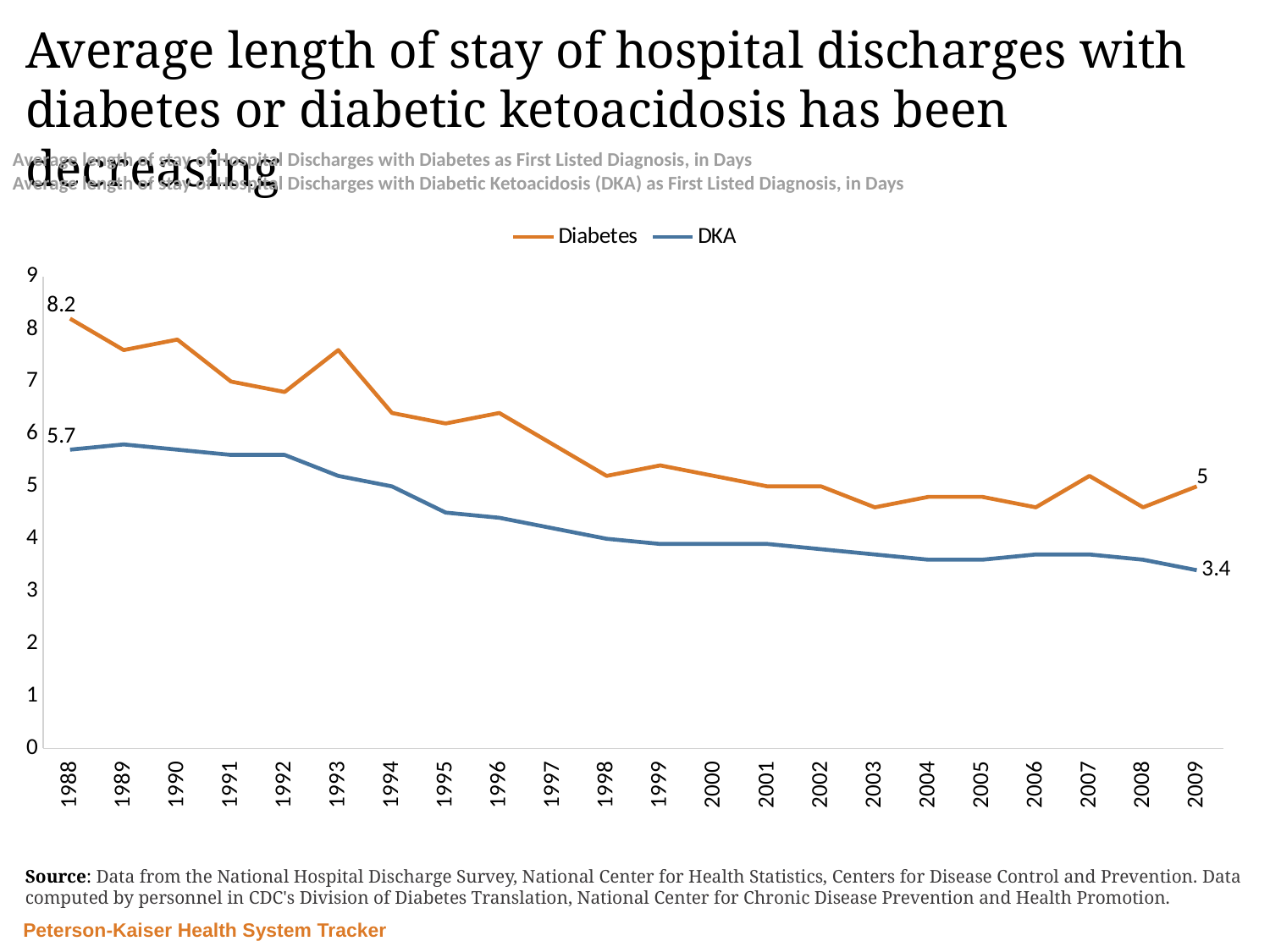
How many series does the legend list? 2 What is the difference between the Diabetes and DKA values in 1988? 2.5 What is the value for DKA in 1988? 5.7 Which series has the larger value in 2009, Diabetes or DKA? Diabetes What kind of chart is shown on the slide? line chart Is the value for DKA in 1995 greater or less than 5? less By how much did the Diabetes value fall from 1988 to 2009? 3.2 What is the value for Diabetes in 1988? 8.2 What is the value for DKA in 2009? 3.4 How many years are shown on the x axis? 22 What is the value for Diabetes in 2009? 5 Is the value for Diabetes in 1993 greater or less than 7? greater